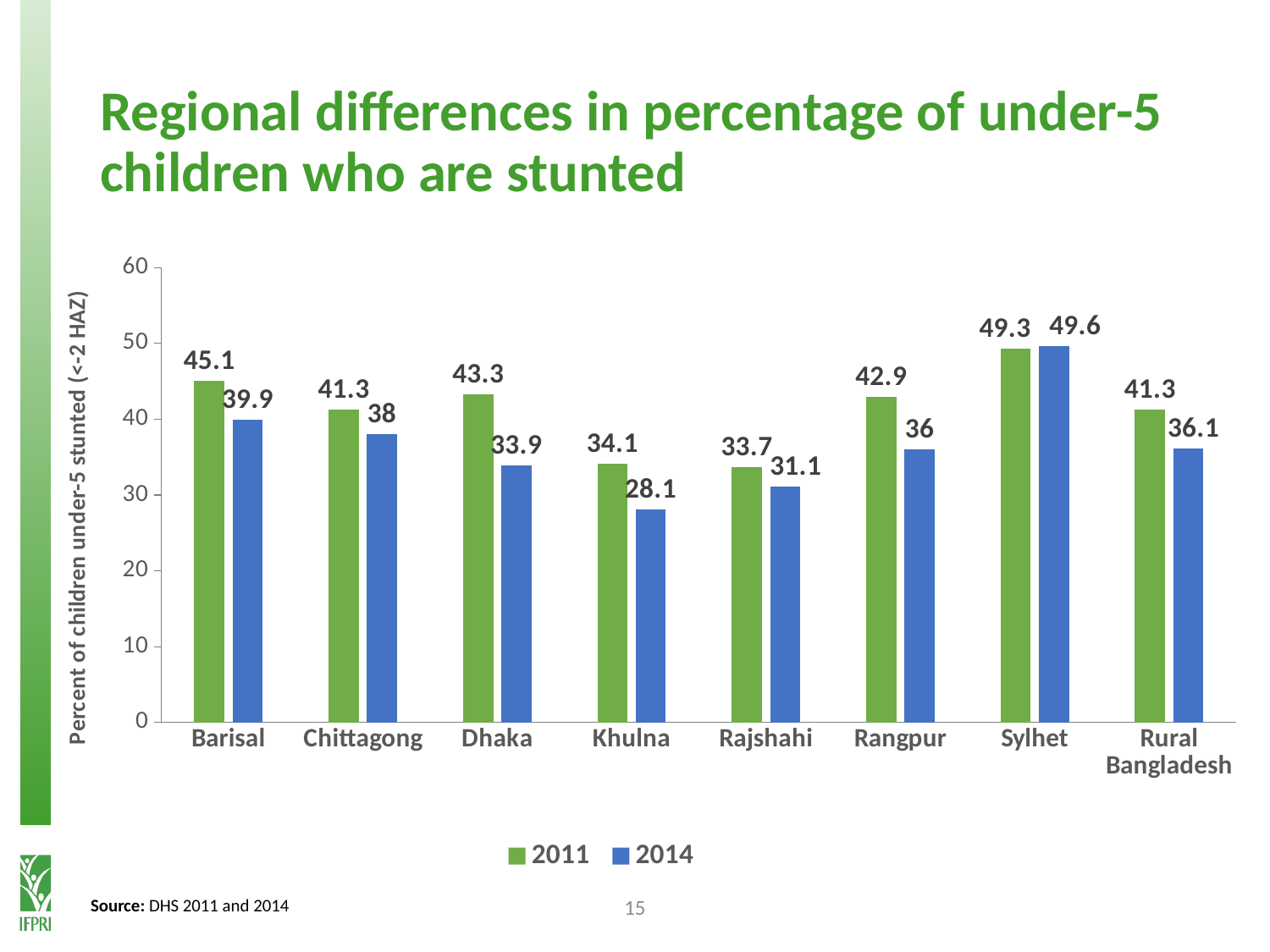
Is the 2014 value for Chittagong greater or less than 40? less What is the 2011 value for Barisal? 45.1 What is the difference between the 2011 and 2014 values for Dhaka? 9.4 How many regions are shown on the x axis? 8 What is the label of the y axis? Percent of children under-5 stunted (<-2 HAZ) What is the 2014 value for Khulna? 28.1 Which region has the lowest 2011 value? Rajshahi What kind of chart is shown on the slide? bar chart Which is larger for Rangpur, the 2011 value or the 2014 value? 2011 How many series does the legend list? 2 What is the 2014 value for Rural Bangladesh? 36.1 Which region has the highest 2014 value? Sylhet